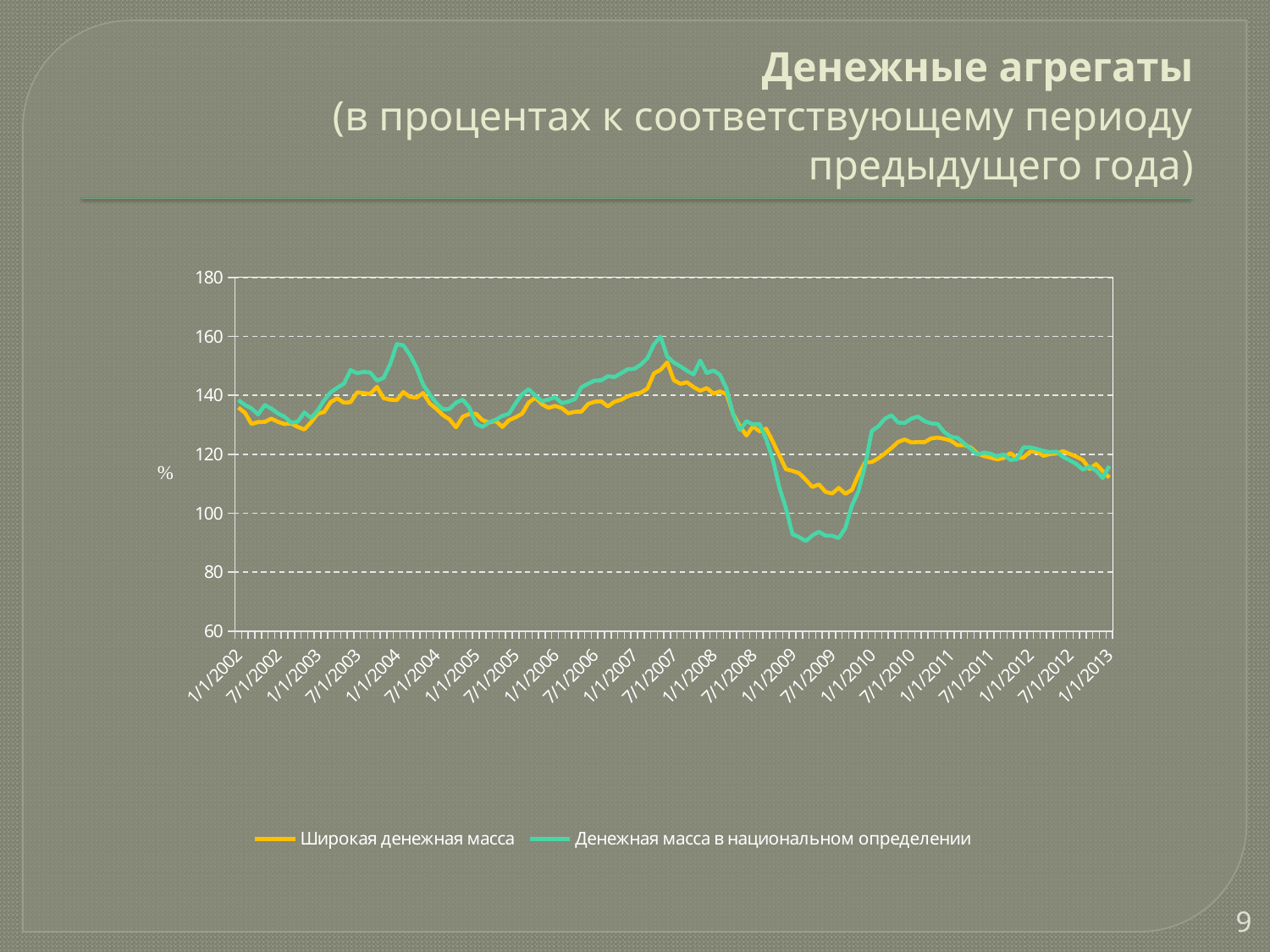
How many series does the legend list? 2 Is the value of 'Широкая денежная масса' at 1/1/2013 greater or less than 120? less Between 7/1/2007 and 1/1/2009, do the values of 'Широкая денежная масса' rise or fall? fall At 1/1/2004, which series has the higher value? Денежная масса в национальном определении Is the value of 'Широкая денежная масса' at 7/1/2009 greater or less than 100? greater Is the value of 'Денежная масса в национальном определении' at 1/1/2009 greater or less than 100? less Which series is drawn in green? Денежная масса в национальном определении What is the title of the chart on the slide? Денежные агрегаты (в процентах к соответствующему периоду предыдущего года) What kind of chart is shown on the slide? line chart At 1/1/2009, which series has the higher value? Широкая денежная масса